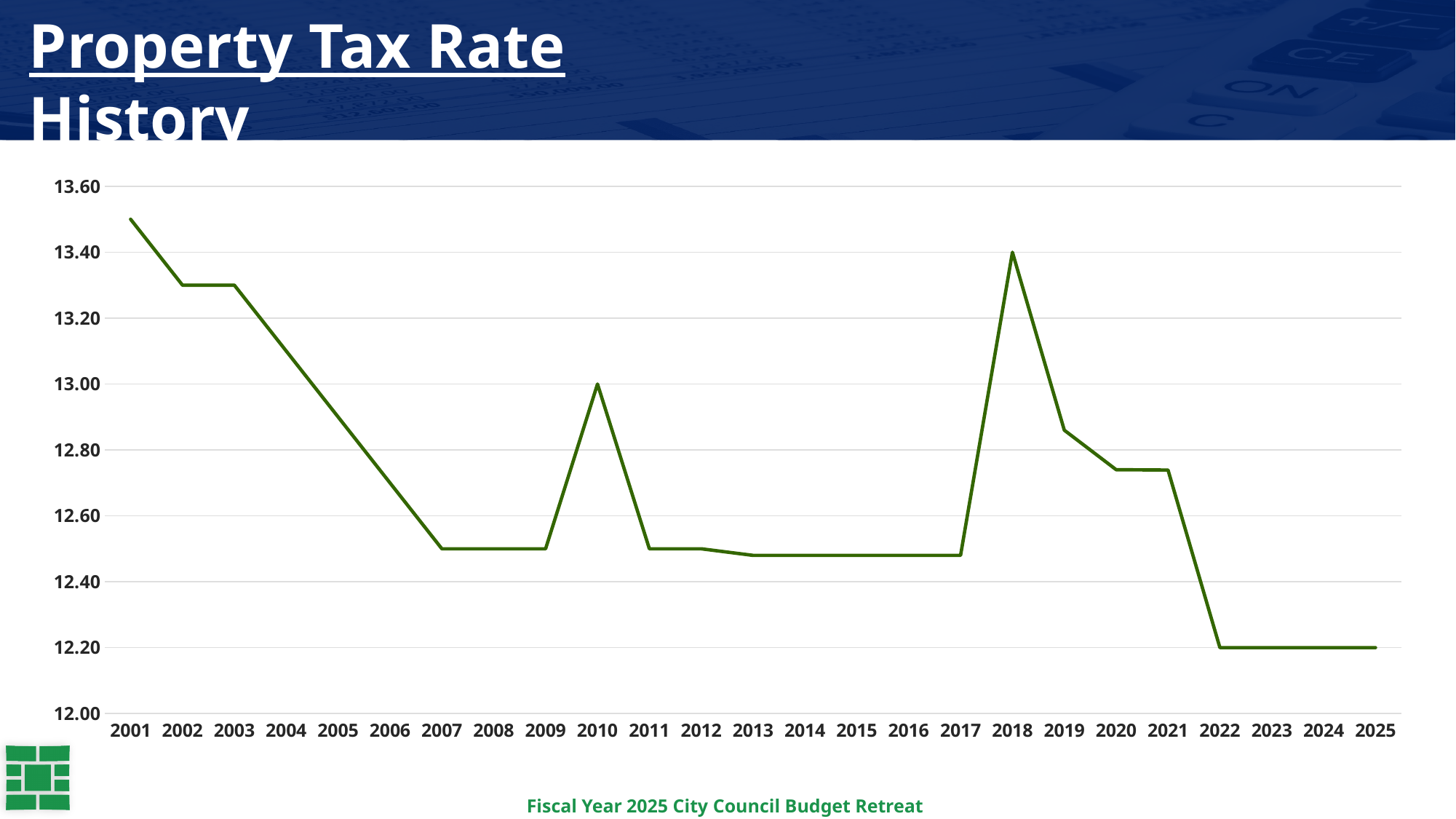
What is the difference between the property tax rate in 2018 and in 2010? 0.40 What kind of chart is shown on the slide? line chart What is the property tax rate in 2018? 13.40 Is the property tax rate in 2019 greater or less than 12.80? greater Which year has the highest property tax rate? 2001 What is the title of the chart on the slide? Property Tax Rate History How many years are plotted along the x axis? 25 Is the property tax rate in 2005 greater or less than 13.00? less What is the property tax rate in 2025? 12.20 What is the property tax rate in 2010? 13.00 Which year has the larger property tax rate, 2001 or 2018? 2001 Overall, does the property tax rate rise or fall from 2001 to 2025? fall